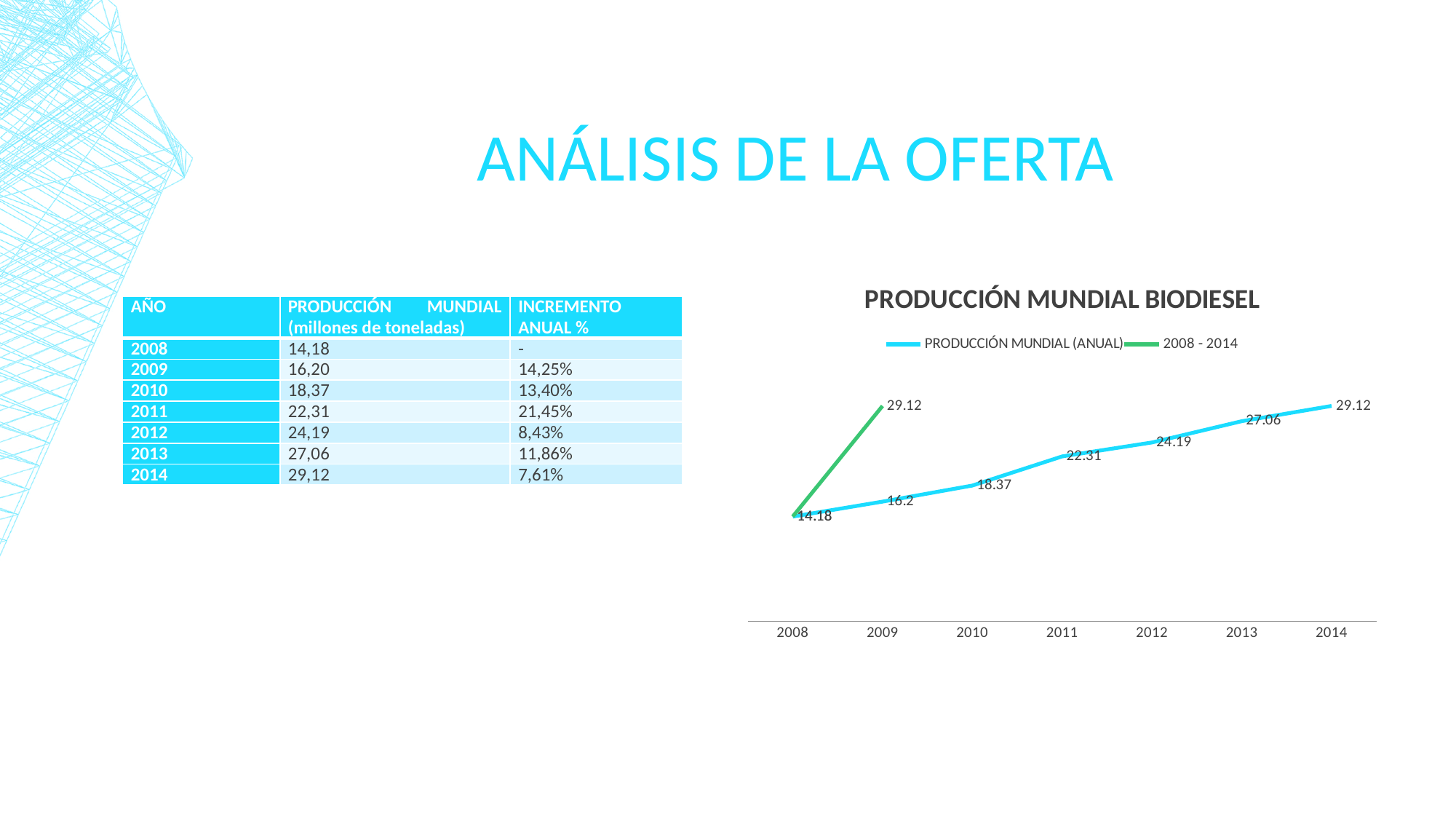
What type of chart is shown under the title PRODUCCIÓN MUNDIAL BIODIESEL? Line chart How many series does the legend of the PRODUCCIÓN MUNDIAL BIODIESEL chart list? 2 In the PRODUCCIÓN MUNDIAL BIODIESEL chart, what is the value of PRODUCCIÓN MUNDIAL (ANUAL) for 2014? 29.12 In the PRODUCCIÓN MUNDIAL BIODIESEL chart, which year has the highest value for PRODUCCIÓN MUNDIAL (ANUAL)? 2014 In the PRODUCCIÓN MUNDIAL BIODIESEL chart, which year has the lowest value for PRODUCCIÓN MUNDIAL (ANUAL)? 2008 In the PRODUCCIÓN MUNDIAL BIODIESEL chart, what colour is the line for the series 2008 - 2014? Green How many years are shown on the x axis of the PRODUCCIÓN MUNDIAL BIODIESEL chart? 7 In the PRODUCCIÓN MUNDIAL BIODIESEL chart, what is the value of PRODUCCIÓN MUNDIAL (ANUAL) for 2008? 14.18 In the PRODUCCIÓN MUNDIAL BIODIESEL chart, does the PRODUCCIÓN MUNDIAL (ANUAL) series rise or fall from 2008 to 2014? Rise In the PRODUCCIÓN MUNDIAL BIODIESEL chart, which is larger for PRODUCCIÓN MUNDIAL (ANUAL): 2010 or 2012? 2012 In the PRODUCCIÓN MUNDIAL BIODIESEL chart, what is the value of PRODUCCIÓN MUNDIAL (ANUAL) for 2011? 22.31 In the PRODUCCIÓN MUNDIAL BIODIESEL chart, what is the difference between the PRODUCCIÓN MUNDIAL (ANUAL) values for 2014 and 2008? 14.94